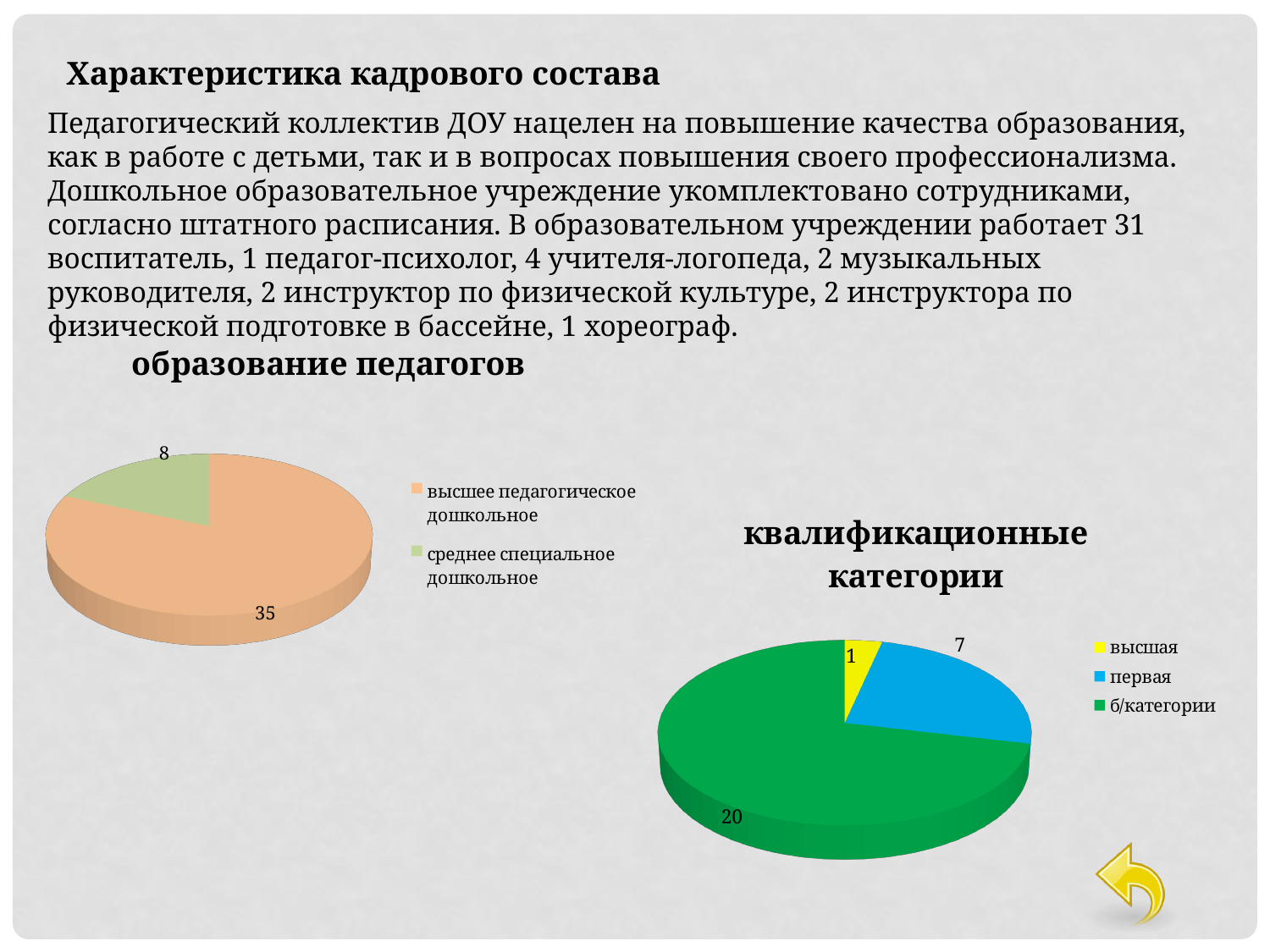
In the chart titled 'квалификационные категории', how many entries does the legend list? 3 What kind of chart is the chart titled 'квалификационные категории'? Pie chart In the chart titled 'образование педагогов', what is the value for 'среднее специальное дошкольное'? 8 In the chart titled 'квалификационные категории', what is the difference between 'б/категории' and 'первая'? 13 In the chart titled 'квалификационные категории', what is the value for 'б/категории'? 20 In the chart titled 'квалификационные категории', which category has the smallest slice? высшая In the chart titled 'образование педагогов', what is the difference between the two slices? 27 In the chart titled 'квалификационные категории', which category has the largest slice? б/категории In the chart titled 'образование педагогов', what is the value for 'высшее педагогическое дошкольное'? 35 In the chart titled 'квалификационные категории', what share of the pie does 'первая' represent? 25% In the chart titled 'квалификационные категории', what is the value for 'первая'? 7 In the chart titled 'образование педагогов', how many slices does the pie have? 2